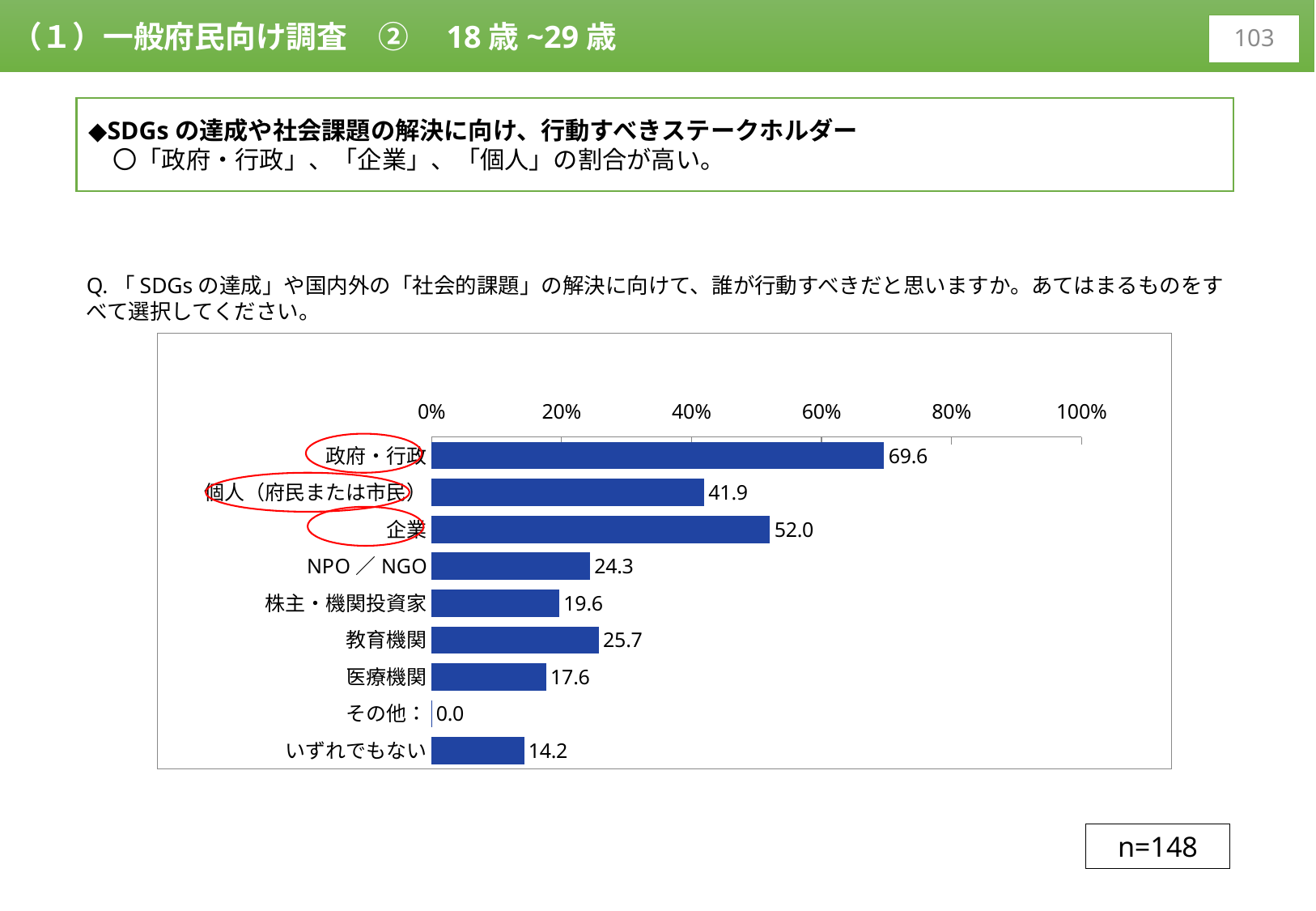
What is the value for いずれでもない? 14.2 What is the value for 企業? 52.0 What kind of chart is shown on the slide? bar chart Which category has the highest value? 政府・行政 Which is larger, the value for 教育機関 or the value for NPO／NGO? 教育機関 What is the value for 株主・機関投資家? 19.6 What is the value for 政府・行政? 69.6 How many categories are shown on the chart? 9 Is the value for 個人（府民または市民） greater or less than 40%? greater What is the sample size shown on the slide? n=148 What is the difference between the values for 政府・行政 and 企業? 17.6 Which category has the lowest value? その他：